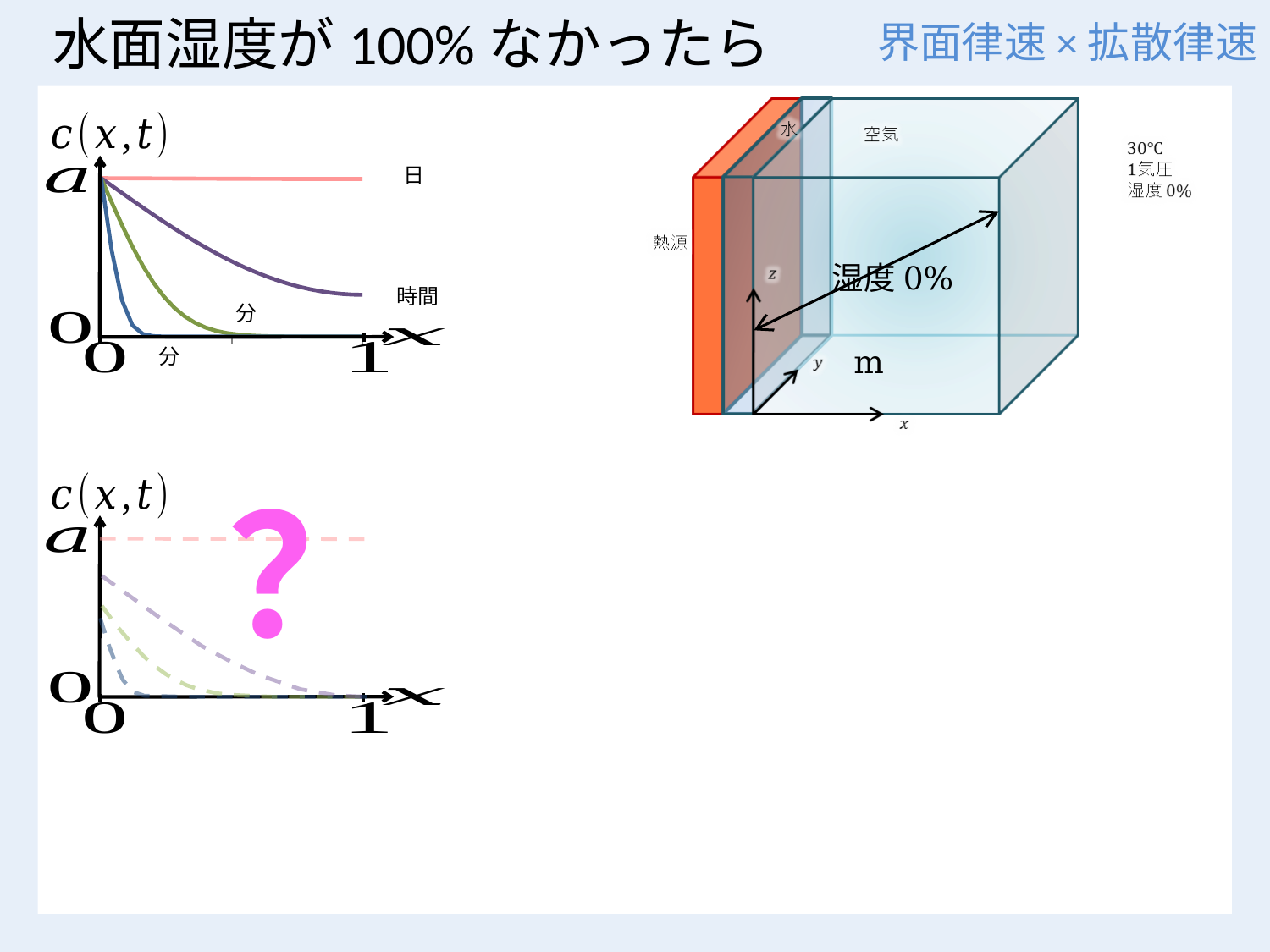
In the top-left chart, what is the label on the vertical axis? c(x,t) In the top-left chart, does the curve labelled 時間 rise or fall as x increases from 0 to 1? fall In the top-left chart, how many curves are plotted? 4 In the bottom-left chart, do the dashed curves rise or fall as x increases? fall In the top-left chart, what are the two tick values shown on the x axis? 0 and 1 What kind of chart is the bottom-left chart? line chart In the top-left chart, at x = 1, which curve is higher: the one labelled 日 or the one labelled 時間? 日 In the bottom-left chart, how many dashed curves fall from the vertical axis toward zero? 3 What kind of chart is the top-left chart of c(x,t) against x? line chart In the top-left chart, which labelled curve stays flat at the level a across the whole x range? 日